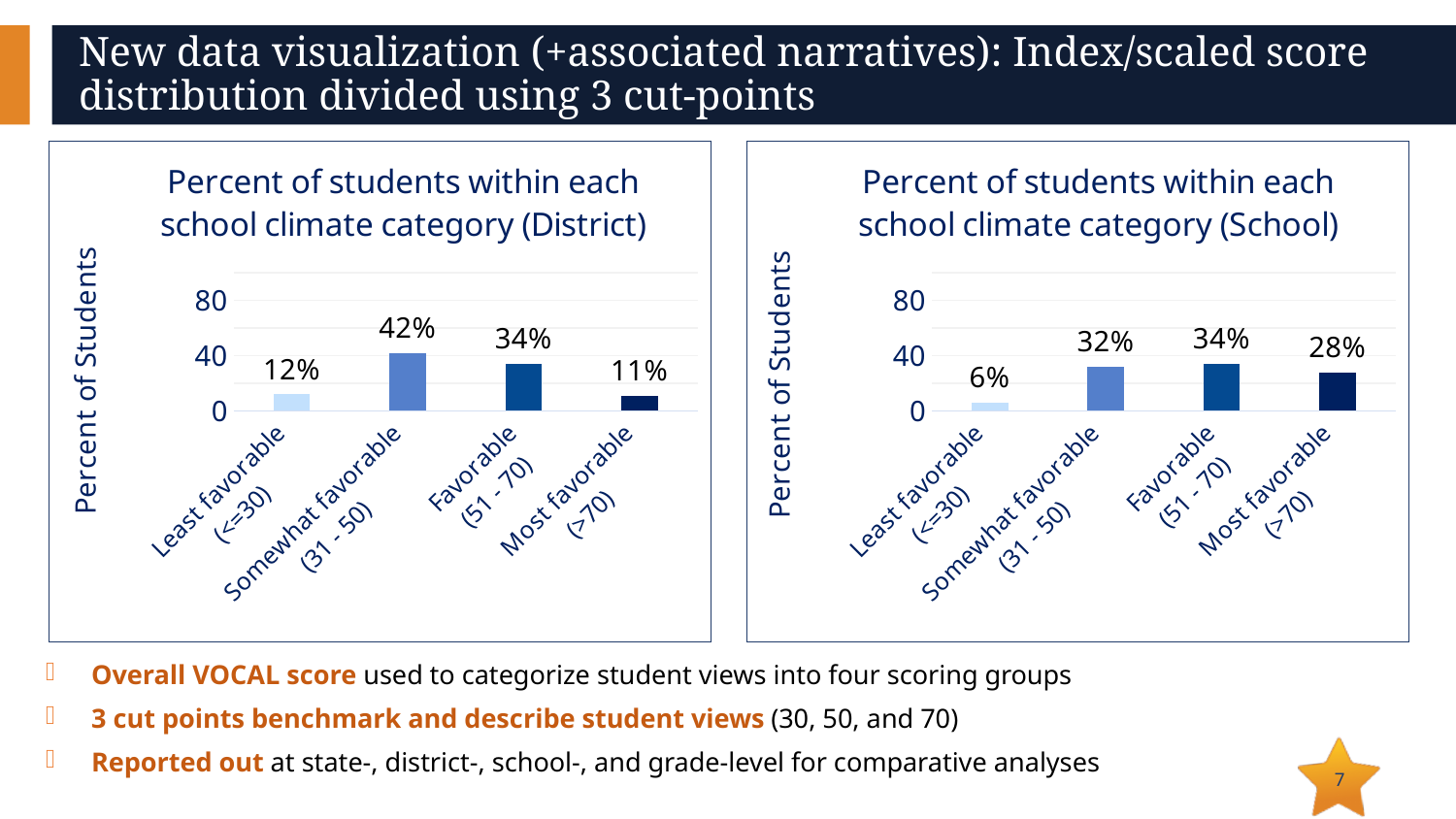
In the District chart, which is larger: the Least favorable value or the Most favorable value? Least favorable In the District chart, what is the difference between the Somewhat favorable and Favorable percentages? 8% In the District chart, what percent of students are in the Somewhat favorable (31 - 50) category? 42% In the District chart, which category has the highest percent of students? Somewhat favorable (31 - 50) How many categories are shown in the District chart? 4 What is the y-axis label of the District chart? Percent of Students What kind of chart is the School chart? bar chart In the School chart, what percent of students are in the Most favorable (>70) category? 28% In the School chart, what is the difference between the Most favorable and Least favorable percentages? 22% In the School chart, is the value for Somewhat favorable (31 - 50) greater or less than 40? less In the School chart, what percent of students are in the Least favorable (<=30) category? 6% In the School chart, which category has the lowest percent of students? Least favorable (<=30)